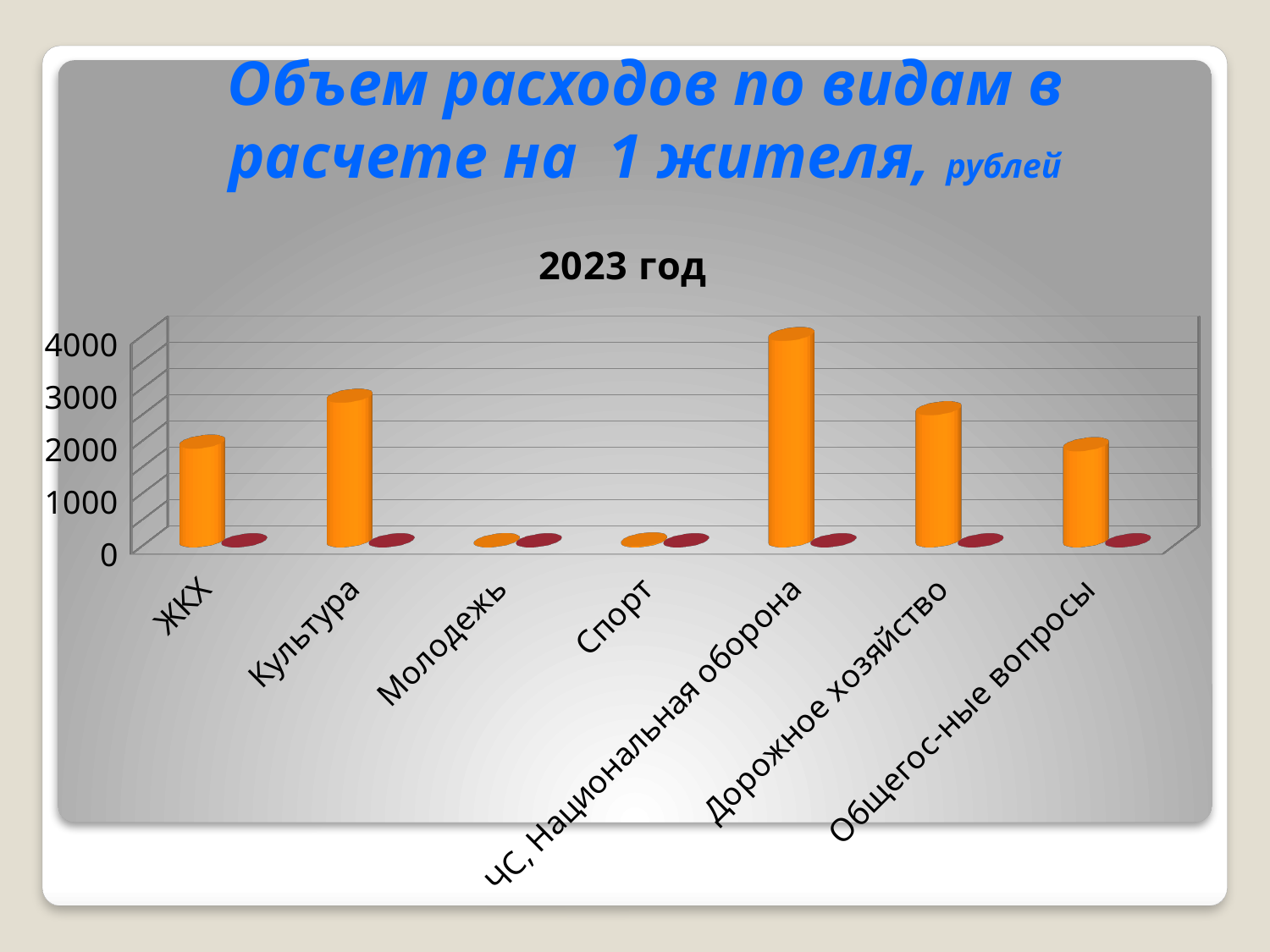
What type of chart is shown on the slide? bar chart Is the value for Спорт greater or less than 1000? less Which category has the highest value in the chart? ЧС, Национальная оборона Is the value for ЧС, Национальная оборона greater or less than 3000? greater Is the value for Молодежь greater or less than 1000? less What is the title printed above the chart? 2023 год How many categories are shown on the x axis of the chart? 7 Which is larger, the value for Культура or the value for ЖКХ? Культура Which is larger, the value for Дорожное хозяйство or the value for Общегос-ные вопросы? Дорожное хозяйство Which is larger, the value for ЧС, Национальная оборона or the value for Дорожное хозяйство? ЧС, Национальная оборона